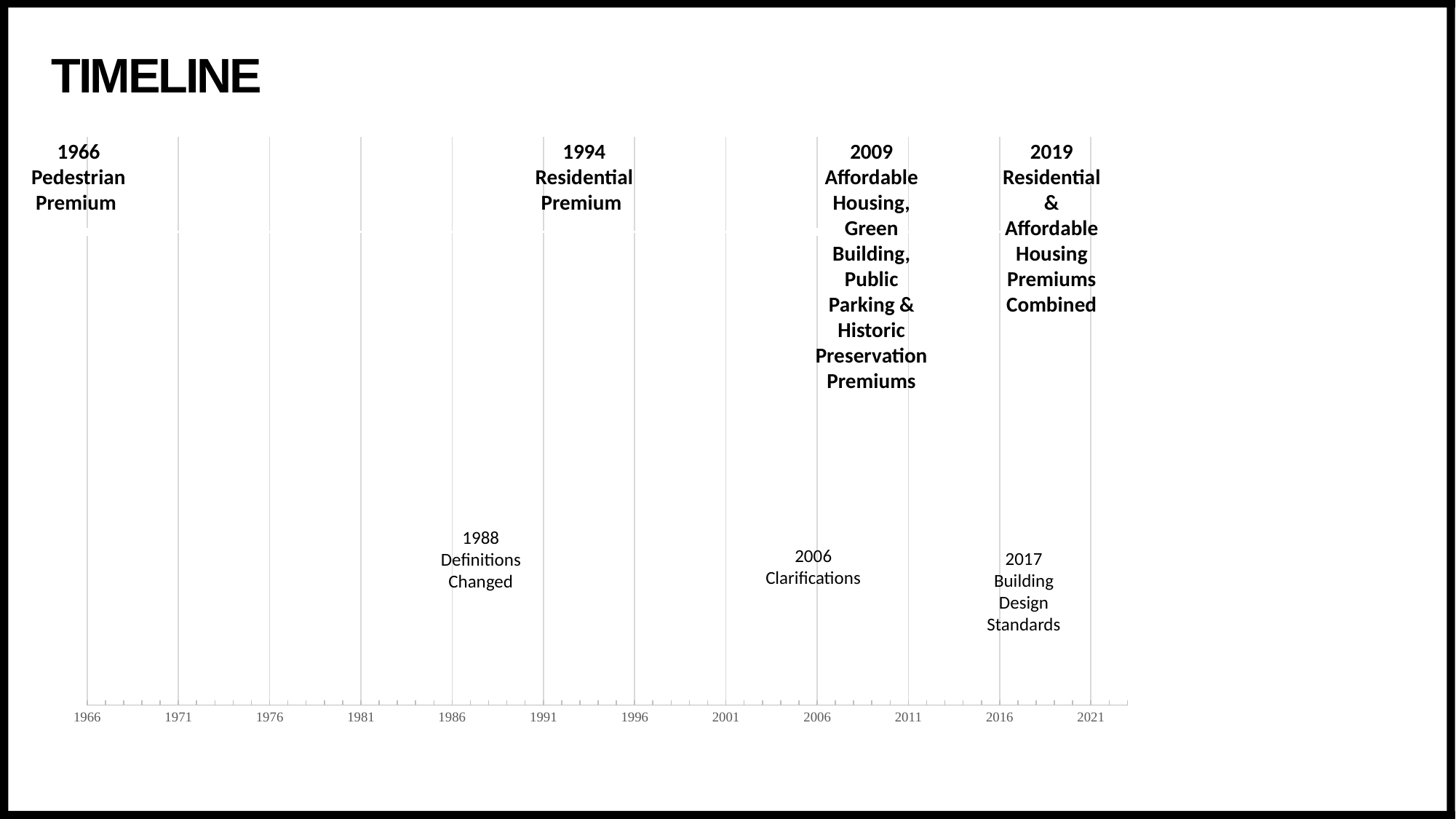
How many events are marked on the timeline? 7 In what year does the timeline mark "Building Design Standards"? 2017 In what year does the timeline mark "Definitions Changed"? 1988 What is the title of the chart on the slide? TIMELINE What event is marked in 1966 on the timeline? Pedestrian Premium How many years separate the Pedestrian Premium (1966) and the Residential Premium (1994) on the timeline? 28 Which is the latest event on the timeline? 2019 Residential & Affordable Housing Premiums Combined What event is marked in 1994 on the timeline? Residential Premium What event is marked in 2019 on the timeline? Residential & Affordable Housing Premiums Combined What is the first year label and the last year label shown on the x axis? 1966 and 2021 In what year does the timeline mark "Clarifications"? 2006 Which is the earliest event on the timeline? 1966 Pedestrian Premium